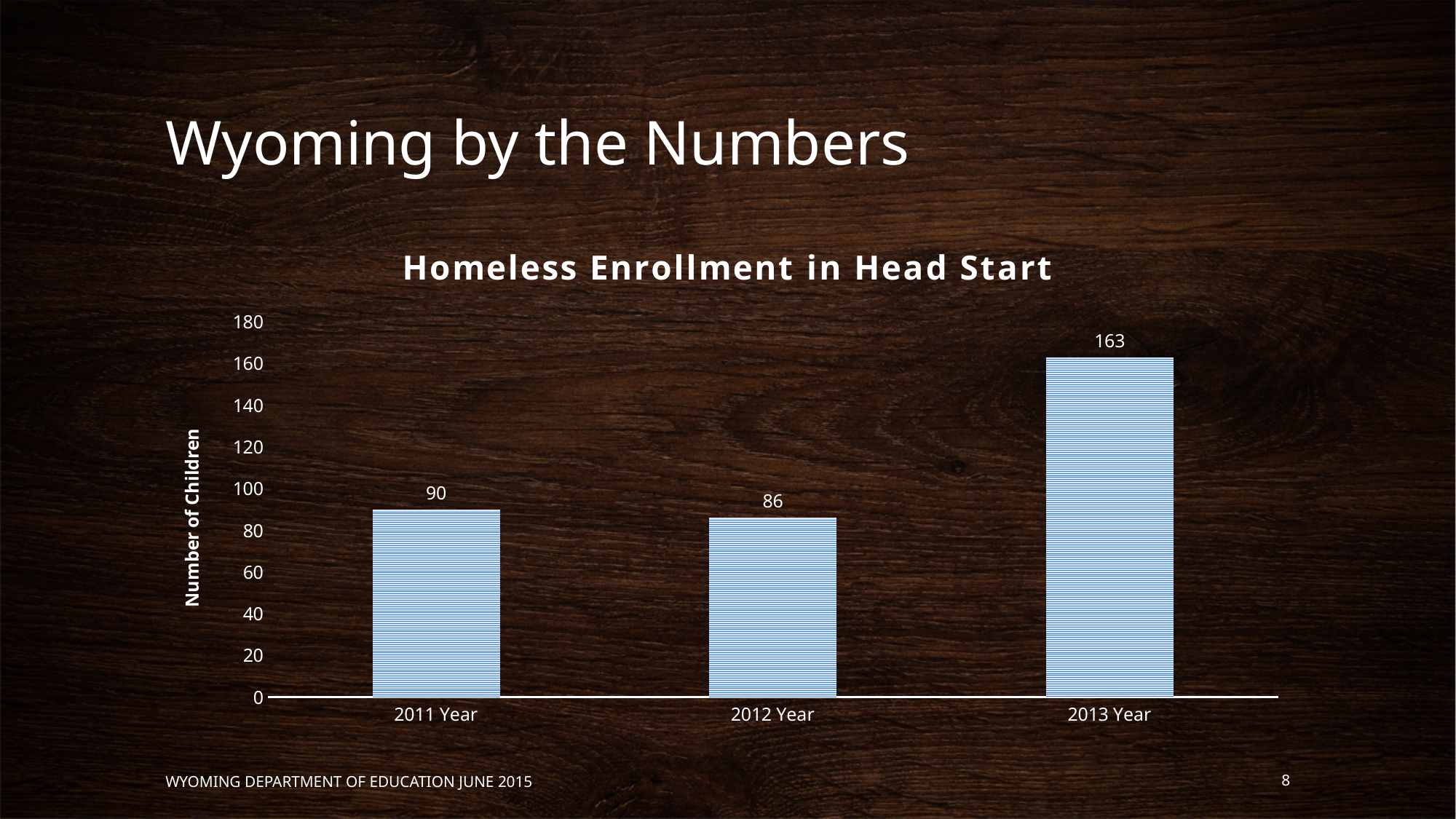
Which is larger, the value for 2013 Year or the value for 2012 Year? 2013 Year What is the value for 2013 Year? 163 What is the value for 2011 Year? 90 Which year has the lowest homeless enrollment in Head Start? 2012 Year What is the difference between the values for 2011 Year and 2012 Year? 4 What is the difference between the values for 2013 Year and 2011 Year? 73 What kind of chart is shown on the slide? bar chart What is the value for 2012 Year? 86 How many years are shown on the chart? 3 Is the value for 2013 Year greater or less than 140? greater What is the title of the chart? Homeless Enrollment in Head Start Which year has the highest homeless enrollment in Head Start? 2013 Year